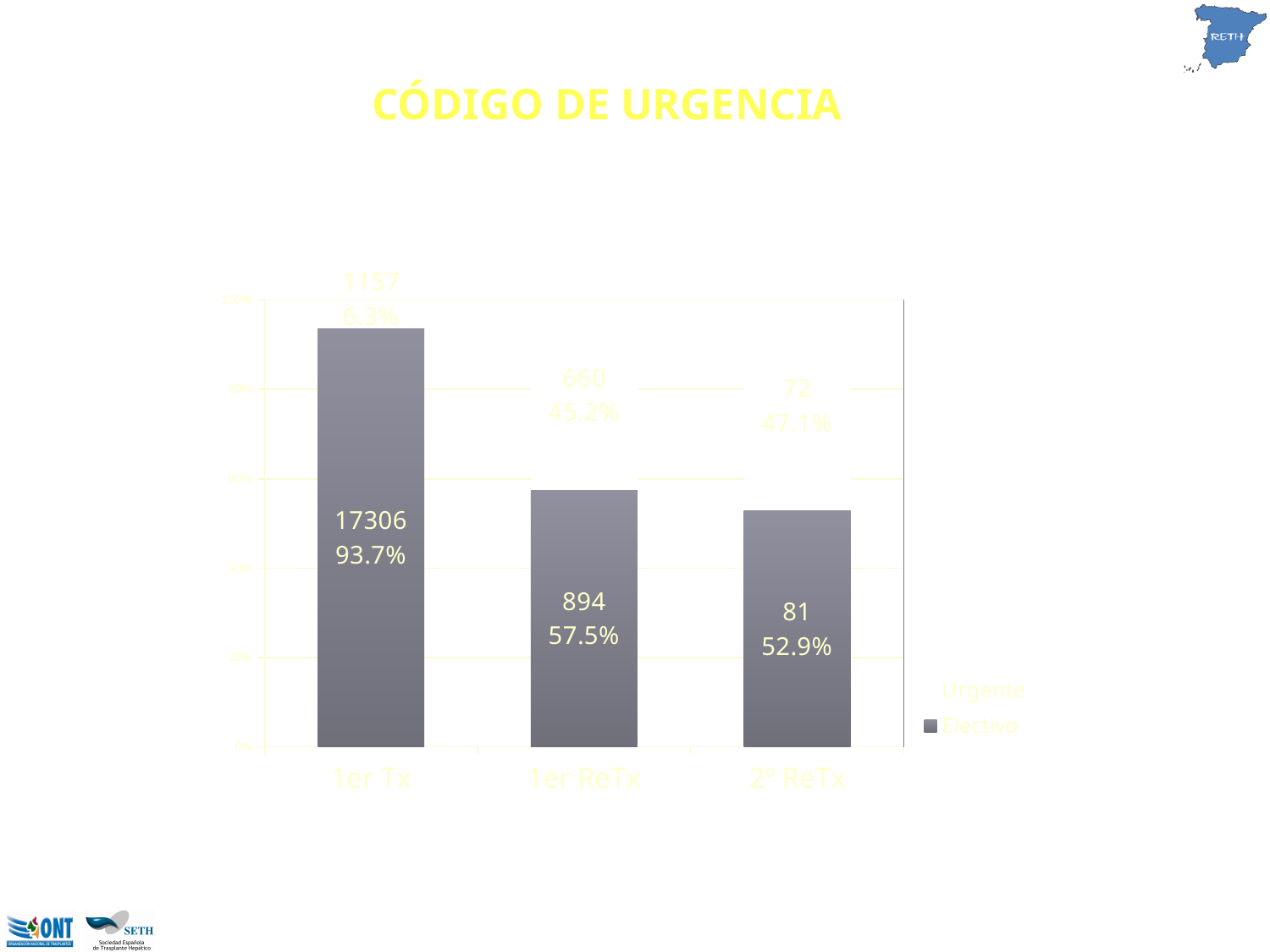
What type of chart is shown on the slide? Stacked bar chart Which category has the lowest Urgente count? 2º ReTx What is the Electivo count for 1er Tx? 17306 What is the title of the chart? CÓDIGO DE URGENCIA What percentage is shown for Electivo in the 2º ReTx category? 52.9% What percentage is shown for Urgente in the 1er Tx category? 6.3% What is the Urgente count for 1er ReTx? 660 What is the difference between the Electivo and Urgente counts for 2º ReTx? 9 How many series does the legend list? 2 How many categories are shown on the x axis? 3 What is the total count (Urgente plus Electivo) for 1er ReTx? 1554 Which category has the highest Electivo percentage? 1er Tx